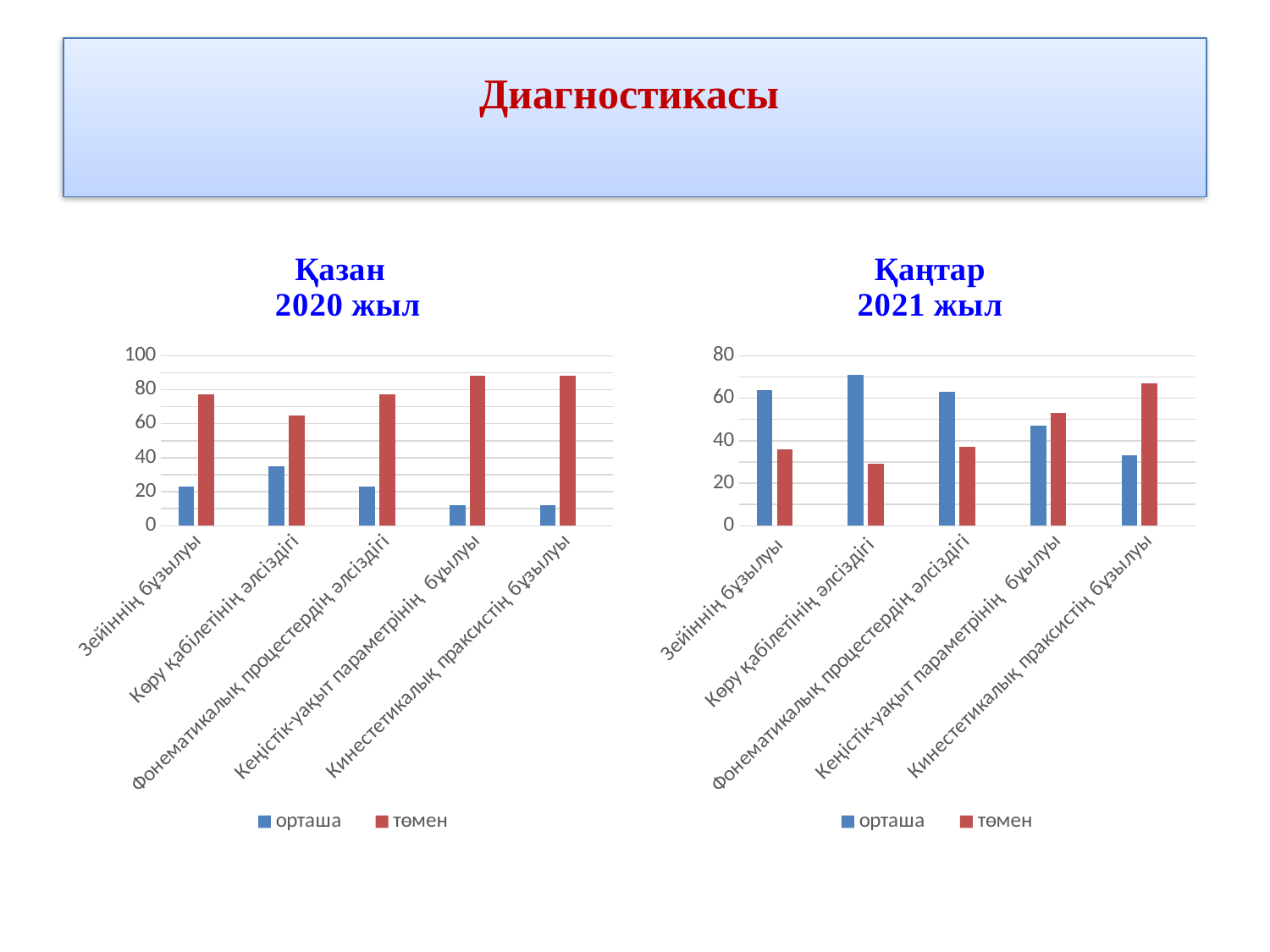
In the "Қазан 2020 жыл" chart, is the "төмен" value for "Зейіннің бұзылуы" greater or less than 60? greater In the "Қаңтар 2021 жыл" chart, which category has the lowest "орташа" value? Кинестетикалық праксистің бұзылуы What kind of chart is the "Қазан 2020 жыл" chart? bar chart How many categories are shown on the x axis of the "Қазан 2020 жыл" chart? 5 How many series does the legend of the "Қаңтар 2021 жыл" chart list? 2 In the "Қазан 2020 жыл" chart, which category has the highest "орташа" value? Көру қабілетінің әлсіздігі In the "Қаңтар 2021 жыл" chart, for "Зейіннің бұзылуы", which series has the larger value, "орташа" or "төмен"? орташа In the "Қаңтар 2021 жыл" chart, which category has the highest "төмен" value? Кинестетикалық праксистің бұзылуы In the "Қаңтар 2021 жыл" chart, is the "орташа" value for "Зейіннің бұзылуы" greater or less than 40? greater In the "Қазан 2020 жыл" chart, is the "орташа" value for "Кеңістік-уақыт параметрінің бұзылуы" greater or less than 20? less What colour are the "төмен" bars in the "Қазан 2020 жыл" chart? red